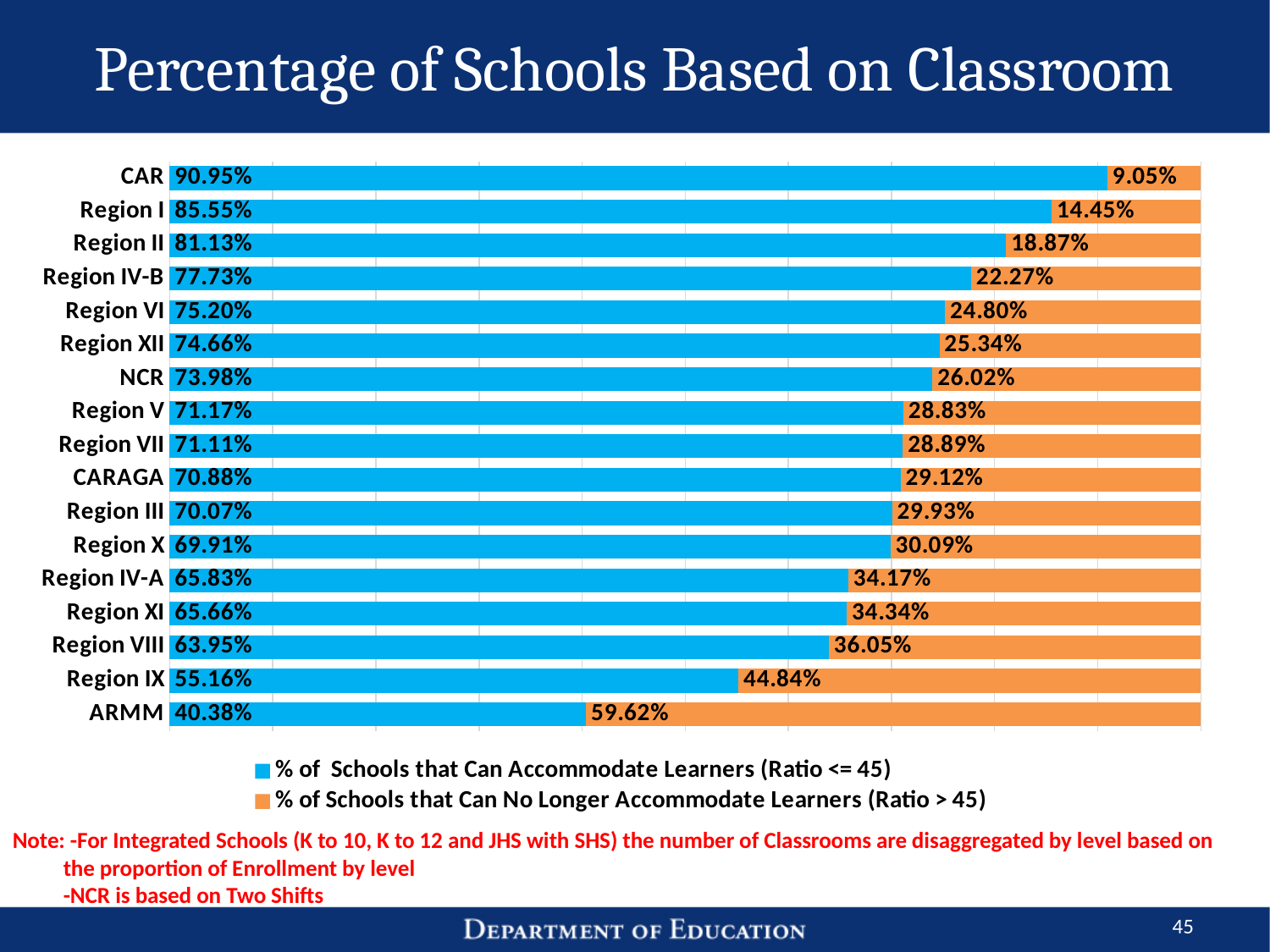
What is the total of the two segments for the Region VI bar? 100.00% What is the difference between the percentage of schools that can accommodate learners in CAR and in ARMM? 50.57% What percentage of schools in ARMM can no longer accommodate learners (Ratio > 45)? 59.62% How many series does the legend list? 2 Which region has the highest percentage of schools that can no longer accommodate learners (Ratio > 45)? ARMM What percentage of schools in CAR can accommodate learners (Ratio <= 45)? 90.95% What type of chart is shown on the slide? Stacked bar chart Which region has the highest percentage of schools that can accommodate learners (Ratio <= 45)? CAR Which region has the lowest percentage of schools that can accommodate learners (Ratio <= 45)? ARMM How many regions are shown in the chart? 17 Which has a higher percentage of schools that can accommodate learners, Region I or Region IX? Region I What percentage of schools in NCR can no longer accommodate learners (Ratio > 45)? 26.02%